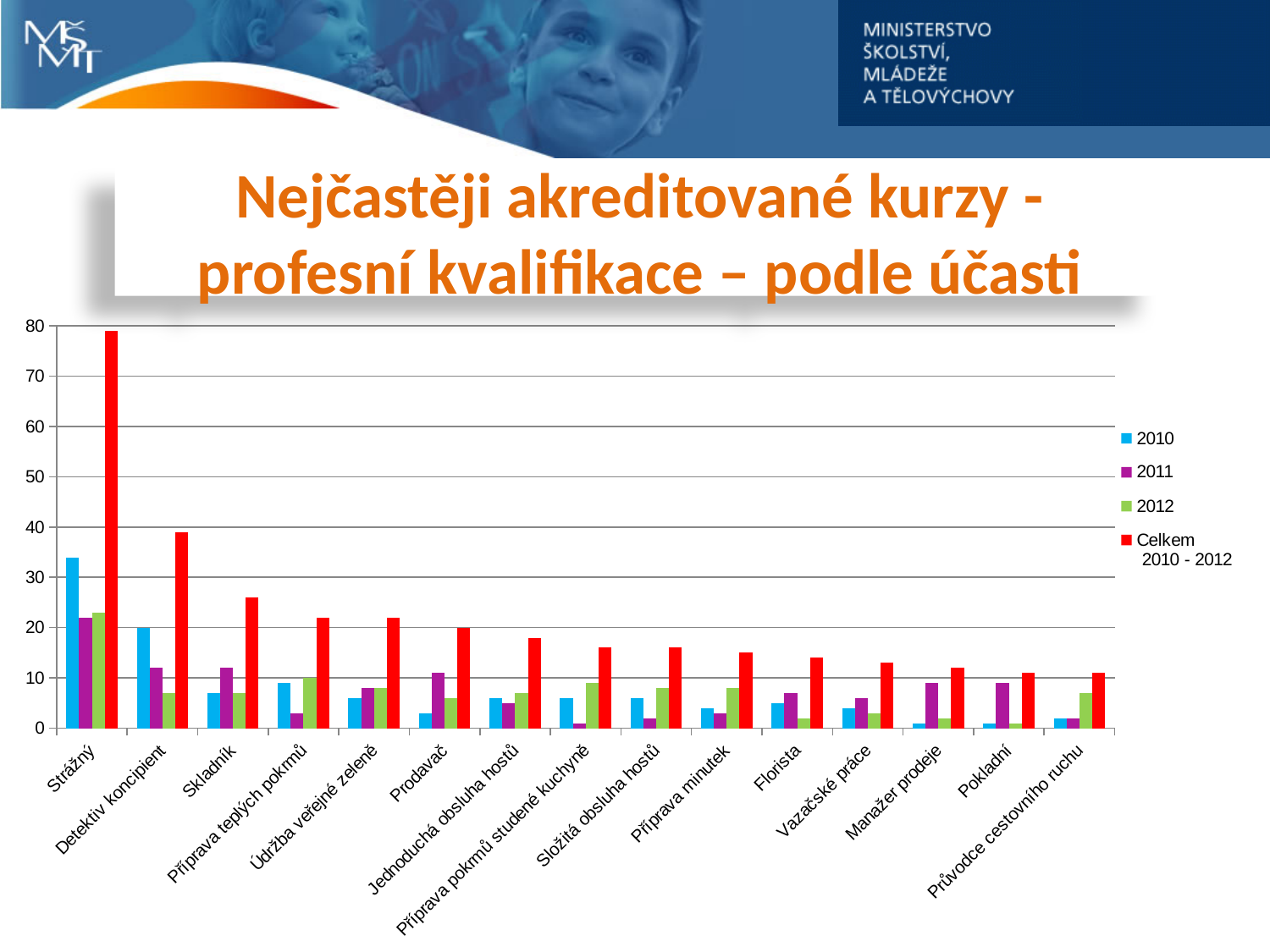
Is the Celkem 2010 - 2012 value for Strážný greater or less than 70? greater What kind of chart is shown on the slide? bar chart For Strážný, which is larger: the 2010 value or the 2011 value? 2010 Which colour represents the series Celkem 2010 - 2012 in the legend? red Is the Celkem 2010 - 2012 value for Skladník greater or less than 30? less Which course has the highest value for the series Celkem 2010 - 2012? Strážný Is the 2010 value for Strážný greater or less than 30? greater How many categories (courses) are shown on the x axis? 15 Do the Celkem 2010 - 2012 values generally rise or fall moving from left to right along the x axis? fall How many series does the legend list? 4